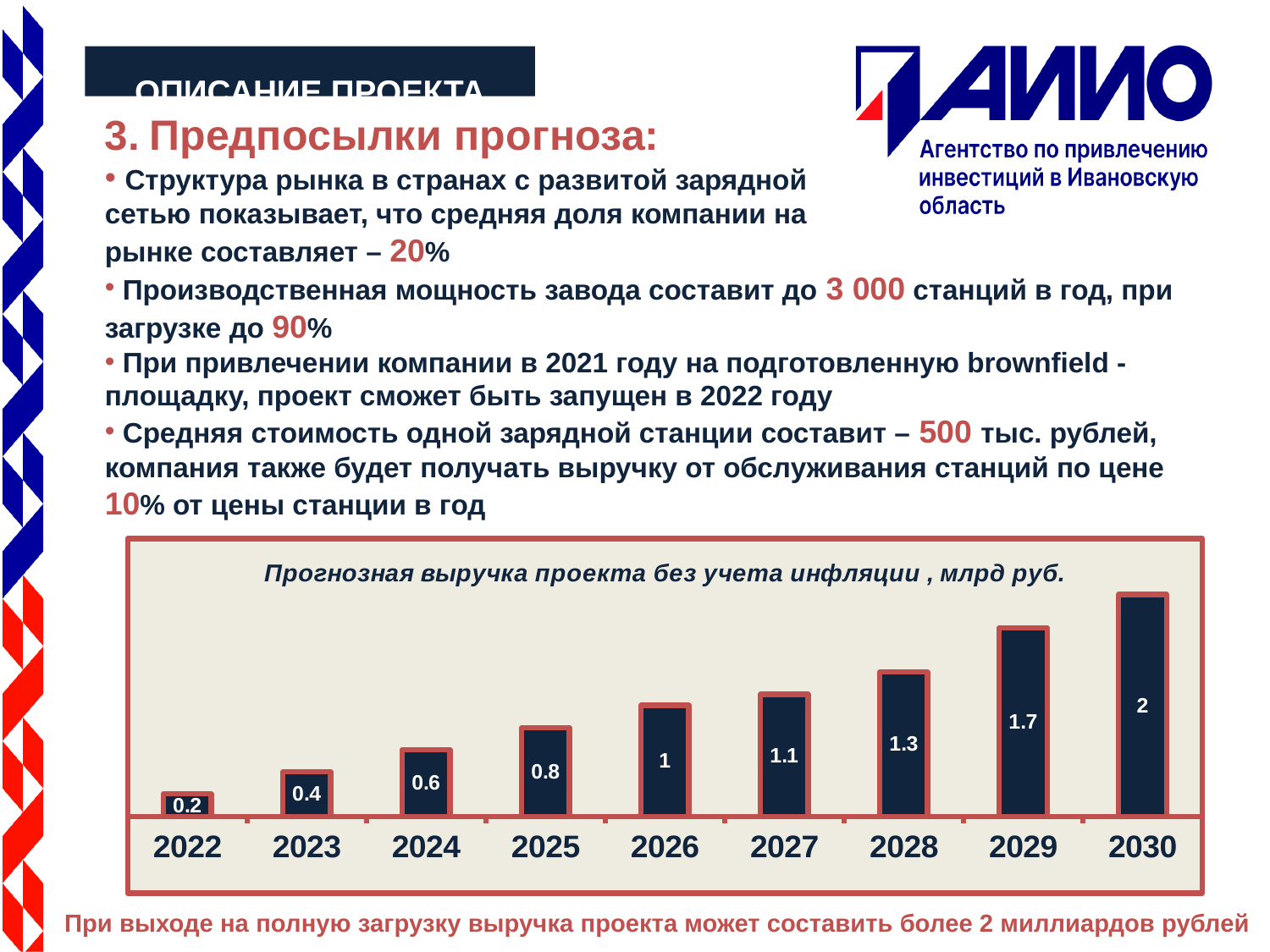
What is the forecast revenue for 2025? 0.8 What is the difference between the forecast revenue for 2028 and 2024? 0.7 Which year has the lowest forecast revenue? 2022 Which year has a larger forecast revenue, 2027 or 2023? 2027 What is the forecast revenue for 2029? 1.7 Which year has the highest forecast revenue? 2030 What is the difference between the forecast revenue for 2030 and 2026? 1 What is the title of the chart? Прогнозная выручка проекта без учета инфляции , млрд руб. What kind of chart is shown on the slide? Bar chart Do the forecast revenue values rise or fall from 2022 to 2030? Rise What is the forecast revenue for 2022? 0.2 How many years are shown on the x axis of the chart? 9